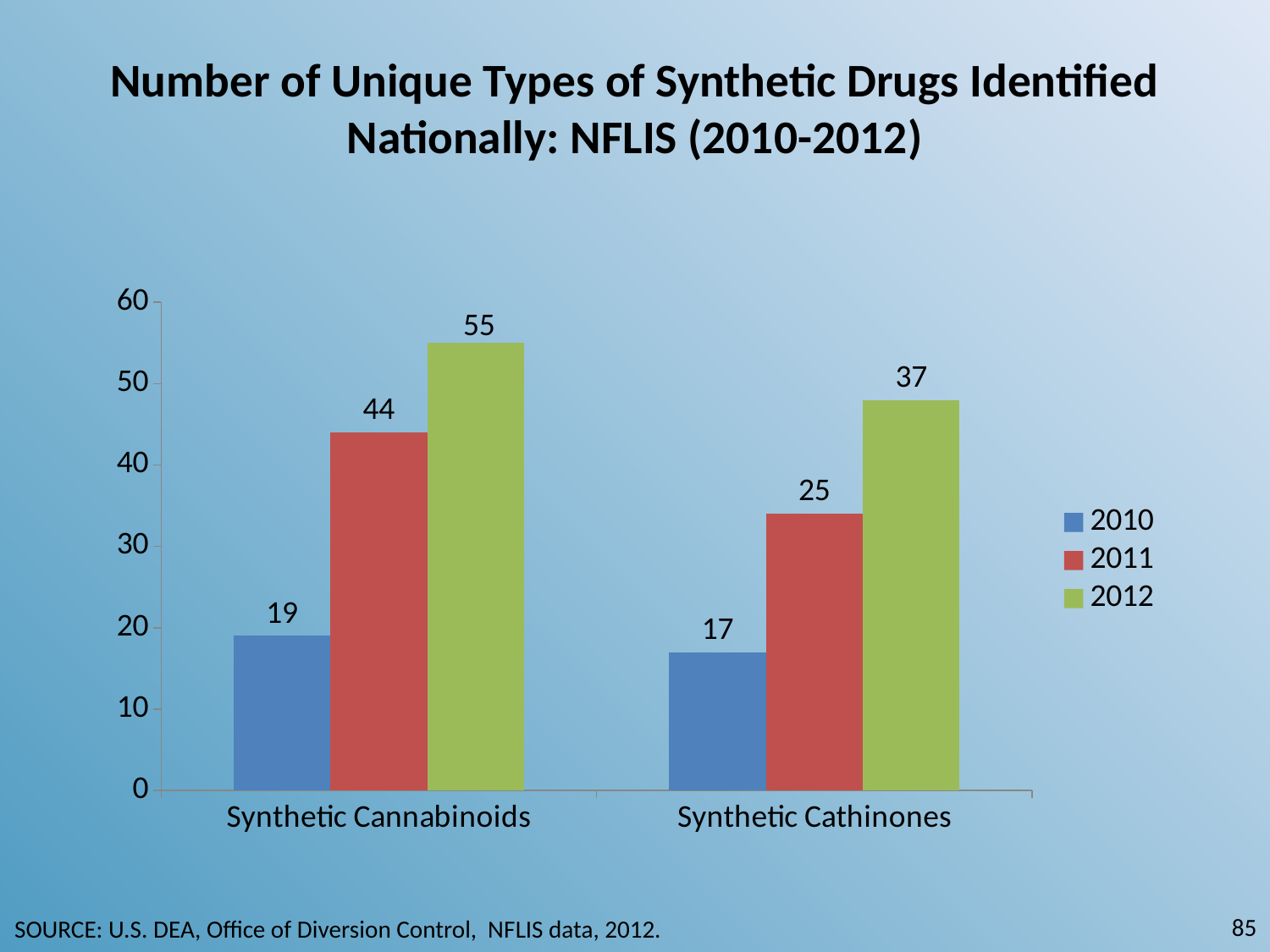
What is the difference between the 2012 and 2010 values for Synthetic Cannabinoids? 36 What kind of chart is shown on the slide? Bar chart What is the value for Synthetic Cannabinoids in 2012? 55 Which year has the lowest value for Synthetic Cathinones? 2010 What is the value for Synthetic Cathinones in 2010? 17 What is the value for Synthetic Cathinones in 2012? 37 What is the value for Synthetic Cannabinoids in 2011? 44 How many series does the legend list? 3 Which year has the highest value for Synthetic Cannabinoids? 2012 What is the difference between the 2011 values for Synthetic Cannabinoids and Synthetic Cathinones? 19 How many categories are shown on the x axis? 2